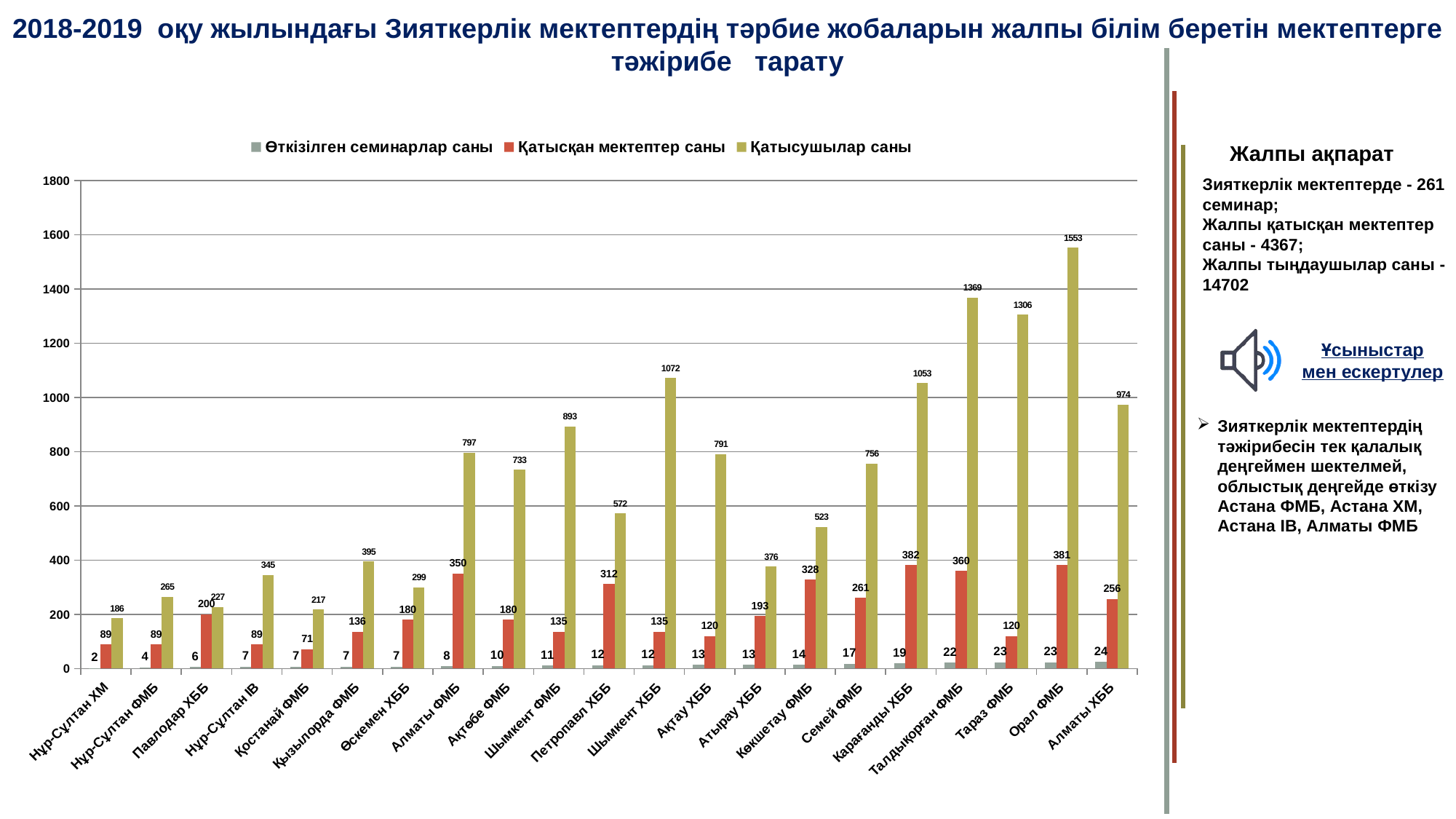
How many categories (schools) are shown on the x axis? 21 What is the value of Өткізілген семинарлар саны for Талдықорған ФМБ? 22 What type of chart is shown on the slide? bar chart Is the value of Қатысушылар саны for Семей ФМБ greater or less than 800? less What is the value of Қатысқан мектептер саны for Алматы ФМБ? 350 Which category has the lowest value for Қатысушылар саны? Нұр-Сұлтан ХМ What is the value of Қатысушылар саны for Орал ФМБ? 1553 Which category has the highest value for Қатысушылар саны? Орал ФМБ What is the difference in Қатысушылар саны between Талдықорған ФМБ and Тараз ФМБ? 63 How many series does the legend list? 3 Which category has the lowest value for Қатысқан мектептер саны? Қостанай ФМБ Which is larger: Қатысушылар саны for Шымкент ХББ or for Қарағанды ХББ? Шымкент ХББ